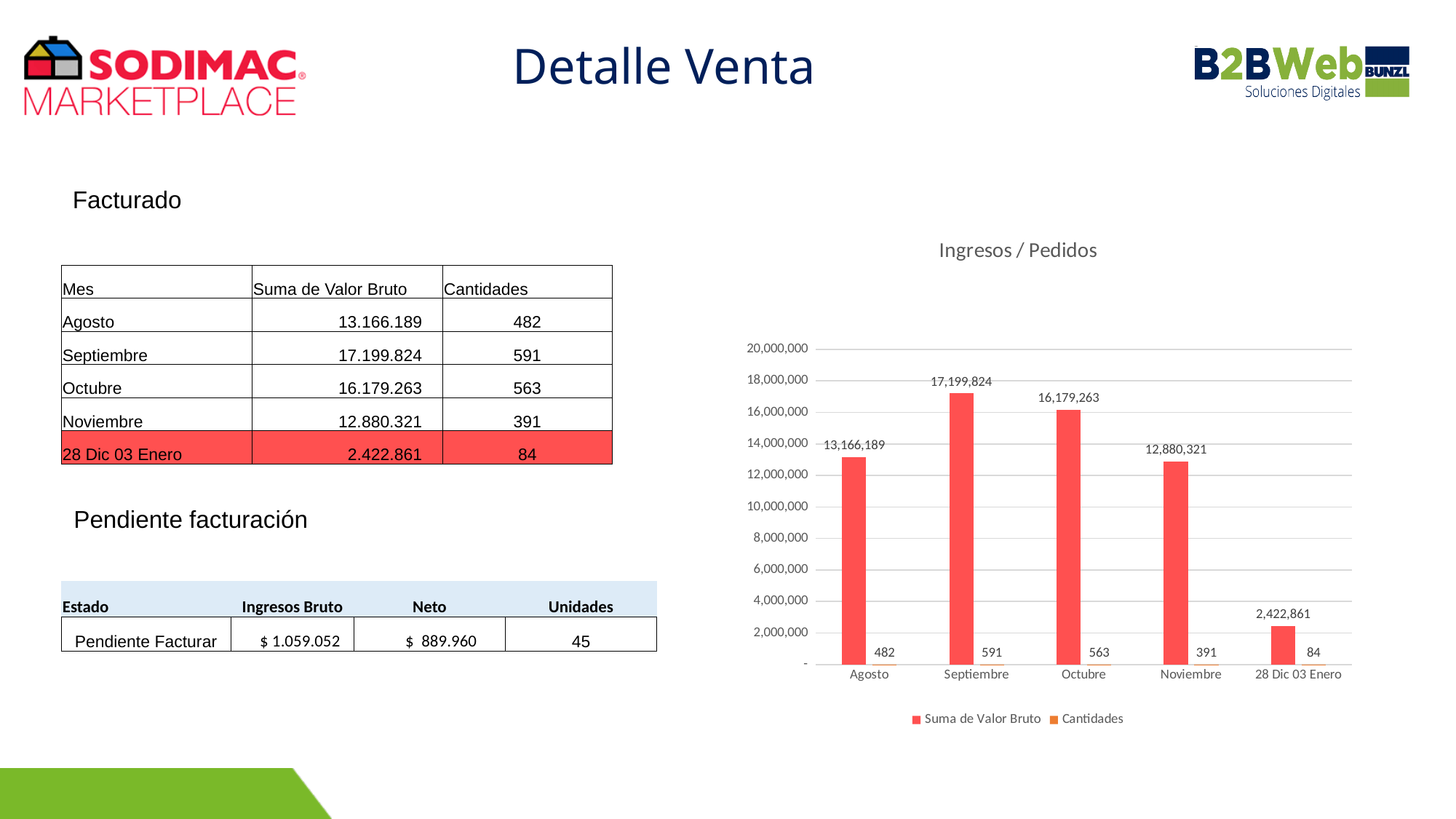
Is the Suma de Valor Bruto for Octubre greater or less than 14,000,000 in the chart? greater What is the difference between the Cantidades for Septiembre and Agosto in the chart? 109 What is the Suma de Valor Bruto value for Septiembre in the chart? 17,199,824 What is the difference between the Suma de Valor Bruto for Septiembre and Octubre in the chart? 1,020,561 Which has a larger Suma de Valor Bruto in the chart, Agosto or Noviembre? Agosto What is the title of the chart on the slide? Ingresos / Pedidos What is the Cantidades value for Noviembre in the chart? 391 What kind of chart is shown on the slide? bar chart Which category has the lowest Suma de Valor Bruto in the chart? 28 Dic 03 Enero Which category has the highest Suma de Valor Bruto in the chart? Septiembre How many series does the chart legend list? 2 How many categories are shown on the x axis of the chart? 5